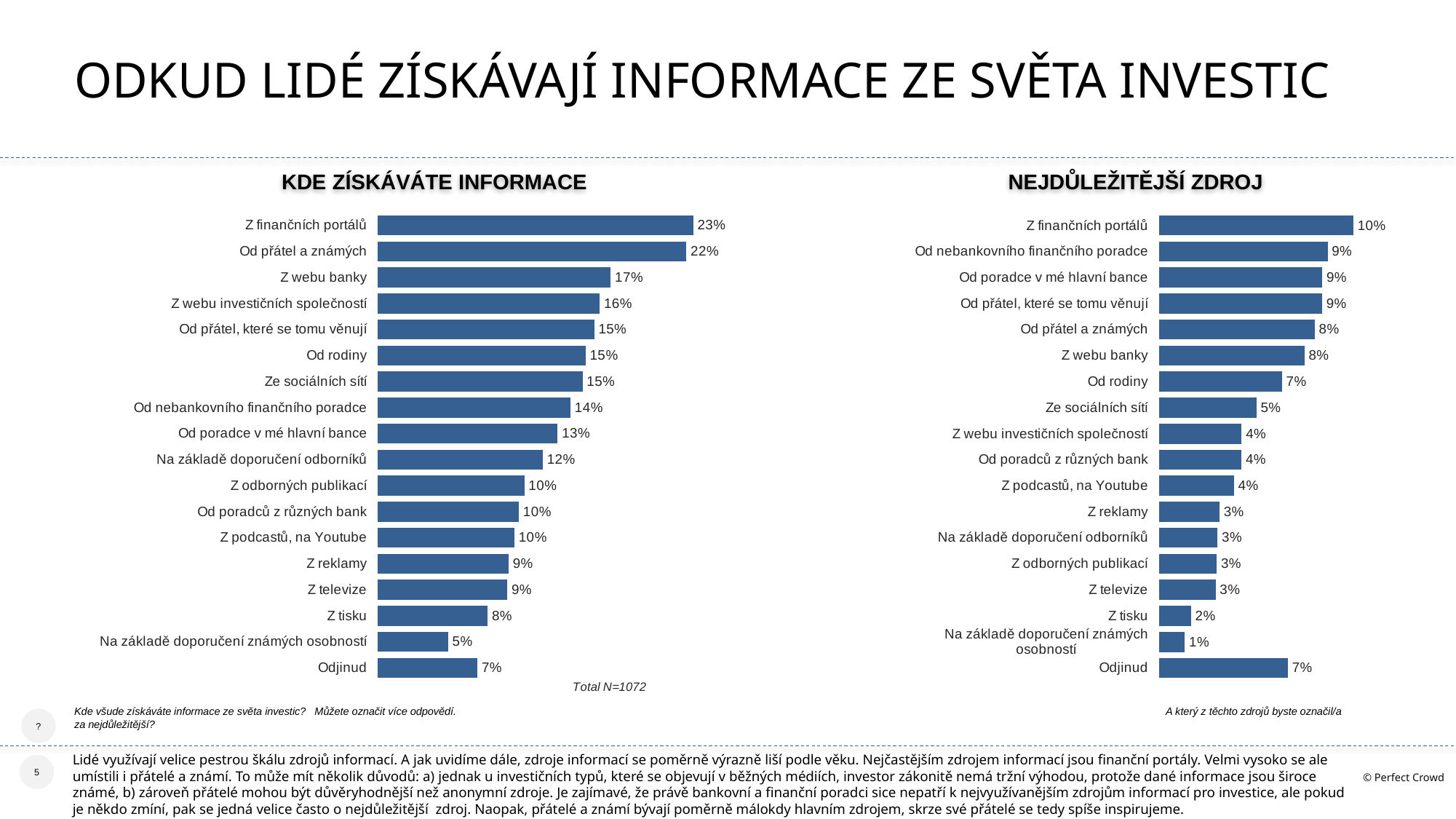
What is the total N stated below the 'KDE ZÍSKÁVÁTE INFORMACE' chart? Total N=1072 How many categories are shown in the 'NEJDŮLEŽITĚJŠÍ ZDROJ' chart? 18 What kind of chart is the 'KDE ZÍSKÁVÁTE INFORMACE' chart? Bar chart In the 'NEJDŮLEŽITĚJŠÍ ZDROJ' chart, which is larger: 'Z webu banky' or 'Z tisku'? Z webu banky In the 'NEJDŮLEŽITĚJŠÍ ZDROJ' chart, which category has the lowest value? Na základě doporučení známých osobností In the 'KDE ZÍSKÁVÁTE INFORMACE' chart, which category has the lowest value? Na základě doporučení známých osobností In the 'NEJDŮLEŽITĚJŠÍ ZDROJ' chart, what is the value for 'Od rodiny'? 7% In the 'KDE ZÍSKÁVÁTE INFORMACE' chart, which category has the highest value? Z finančních portálů In the 'KDE ZÍSKÁVÁTE INFORMACE' chart, which is larger: 'Od přátel a známých' or 'Z webu investičních společností'? Od přátel a známých In the 'NEJDŮLEŽITĚJŠÍ ZDROJ' chart, what is the difference between 'Z finančních portálů' and 'Ze sociálních sítí'? 5% In the 'KDE ZÍSKÁVÁTE INFORMACE' chart, what is the value for 'Z webu banky'? 17% In the 'KDE ZÍSKÁVÁTE INFORMACE' chart, what is the difference between 'Z finančních portálů' and 'Z tisku'? 15%